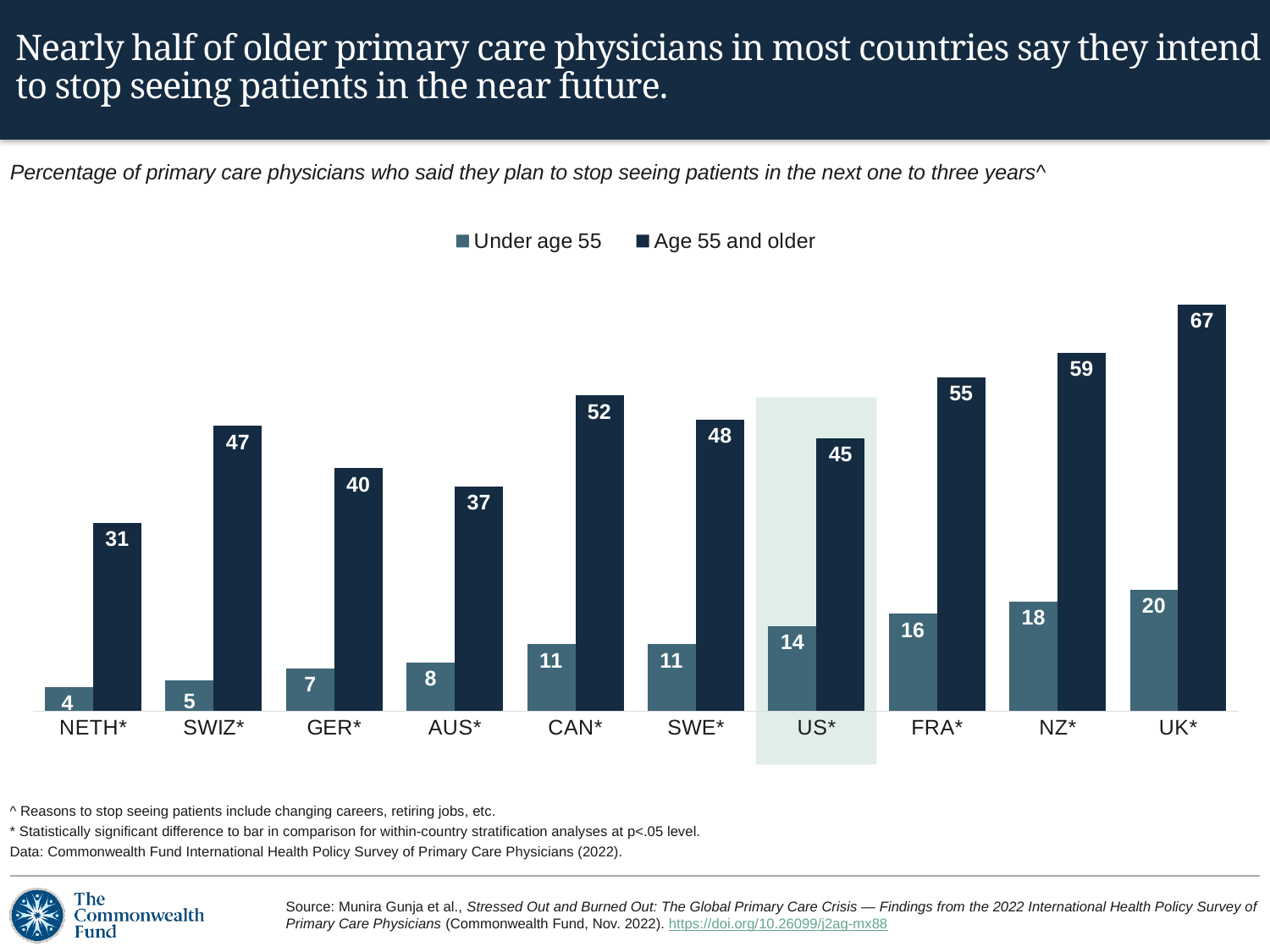
Which country has the highest value for Age 55 and older? UK* Which country has the lowest value for Under age 55? NETH* What kind of chart is shown on the slide? Bar chart What is the value for Under age 55 in GER*? 7 How many countries are shown on the x axis? 10 What is the difference between the Age 55 and older and Under age 55 values for CAN*? 41 Do the Age 55 and older values generally rise or fall from NETH* to UK* along the x axis? Rise What is the value for Under age 55 in NZ*? 18 Which is larger: the Age 55 and older value for SWE* or for AUS*? SWE* What is the value for Age 55 and older in the US*? 45 Which country's bars are highlighted with a shaded background? US* How many series does the legend list? 2